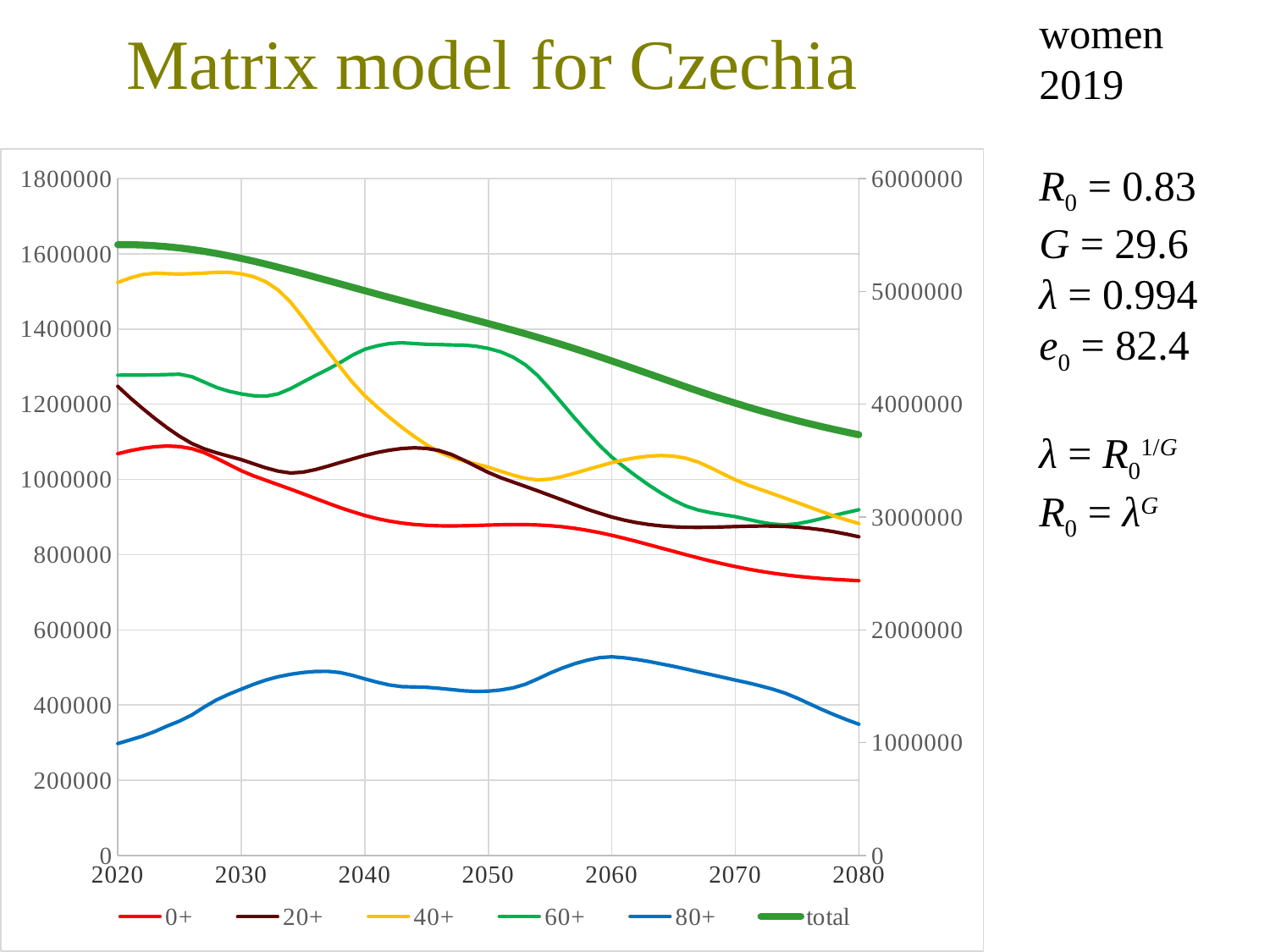
Is the value for total in 2080 greater or less than 4000000 on the right axis? less Does the total series rise or fall from 2020 to 2080? fall Which age-group series has the highest value in 2020? 40+ Which series has the lowest values across the whole period? 80+ How many series does the chart legend list? 6 Does the 80+ series rise or fall between 2020 and 2060? rise In 2020, which is larger: the value for 20+ or the value for 0+? 20+ What kind of chart is shown on the slide? line chart Is the value for 0+ in 2080 greater or less than 800000? less What is the title of the slide containing the chart? Matrix model for Czechia Is the value for 40+ in 2020 greater or less than 1400000? greater